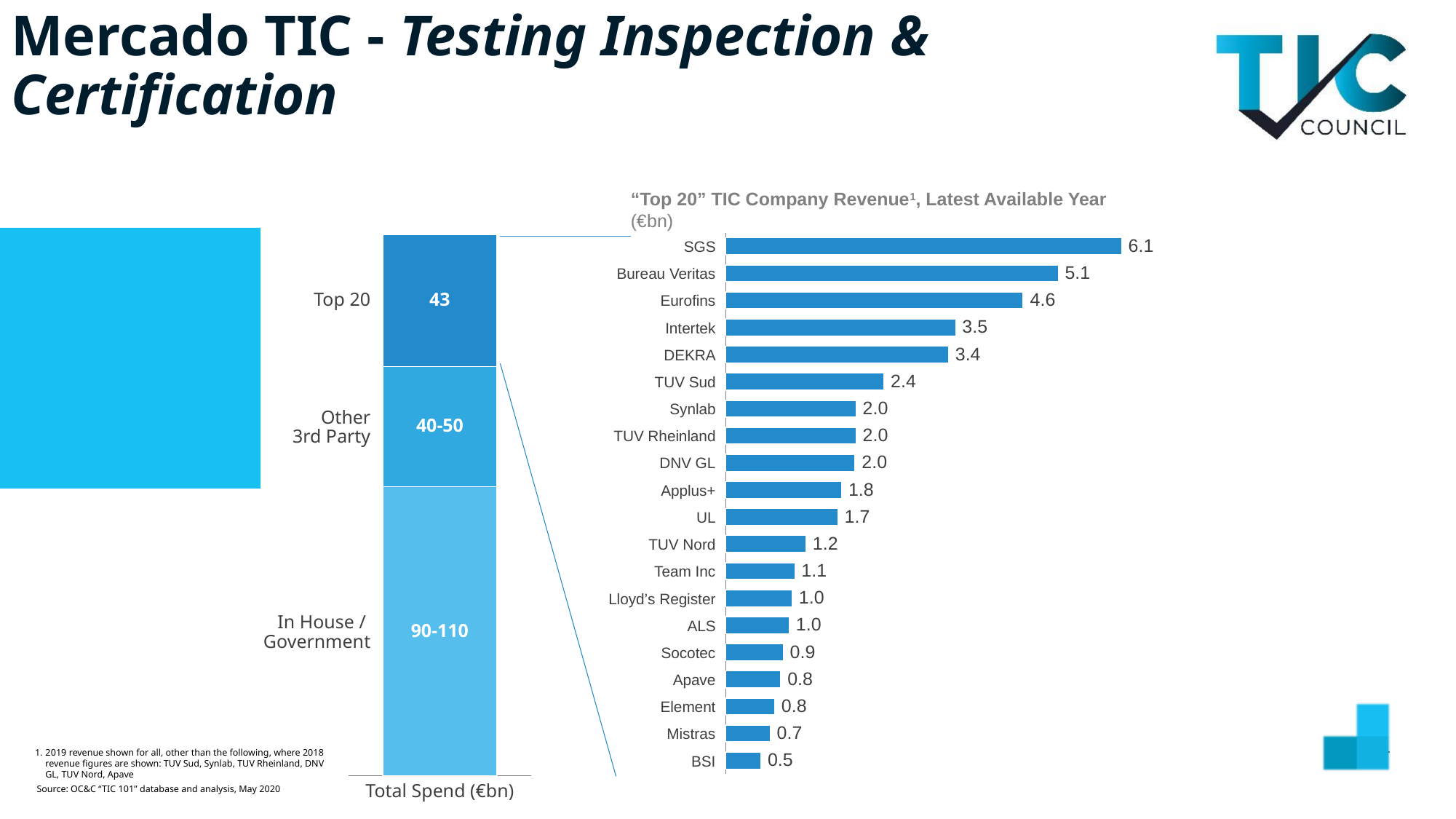
In the "Top 20" TIC Company Revenue chart, what unit is given in the title? €bn In the "Top 20" TIC Company Revenue chart, how many companies are listed? 20 In the Total Spend (€bn) chart on the left, what value is shown for the In House / Government segment? 90-110 In the "Top 20" TIC Company Revenue chart, which company has the lowest revenue? BSI In the Total Spend (€bn) chart on the left, how many segments make up the stacked bar? 3 In the "Top 20" TIC Company Revenue chart, which has the larger revenue, Eurofins or DEKRA? Eurofins In the "Top 20" TIC Company Revenue chart, what is the revenue shown for SGS? 6.1 What kind of chart is the "Top 20" TIC Company Revenue chart? Bar chart In the "Top 20" TIC Company Revenue chart, what is the difference between the revenue of SGS and Bureau Veritas? 1.0 In the "Top 20" TIC Company Revenue chart, which company has the highest revenue? SGS In the Total Spend (€bn) chart on the left, what value is shown for the Top 20 segment? 43 In the "Top 20" TIC Company Revenue chart, what is the revenue shown for Intertek? 3.5